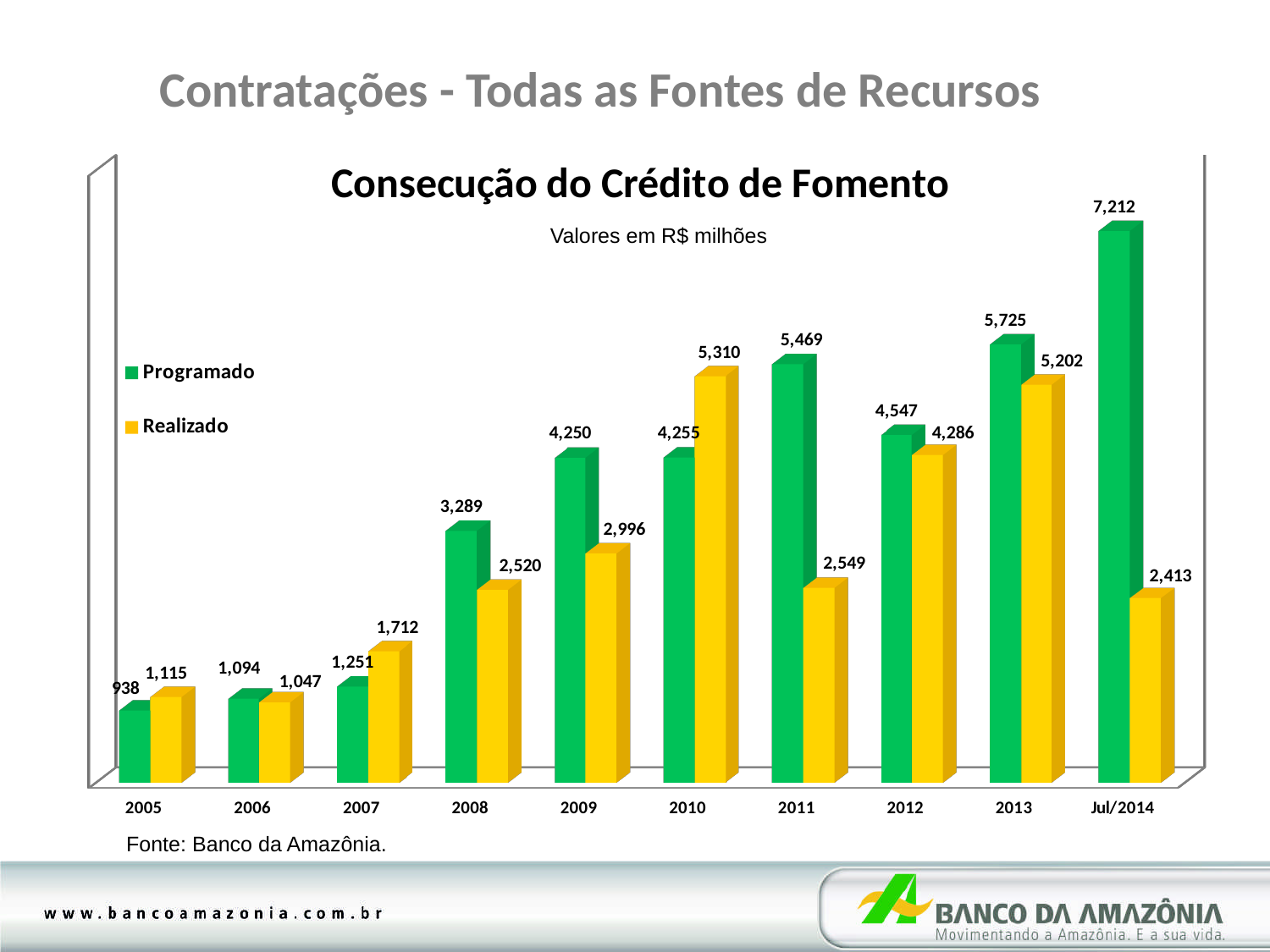
How many categories are shown on the x axis? 10 Which is larger in 2007, the Programado value or the Realizado value? Realizado What is the Programado value for 2011? 5,469 What is the Realizado value for Jul/2014? 2,413 Does the Programado series generally rise or fall from 2005 to Jul/2014? Rise What unit are the values in, according to the chart subtitle? R$ milhões Which category has the lowest Realizado value? 2006 What kind of chart is shown on the slide? Bar chart How many series does the legend list? 2 What is the difference between the Programado and Realizado values for 2013? 523 What is the Realizado value for 2010? 5,310 Which category has the highest Programado value? Jul/2014